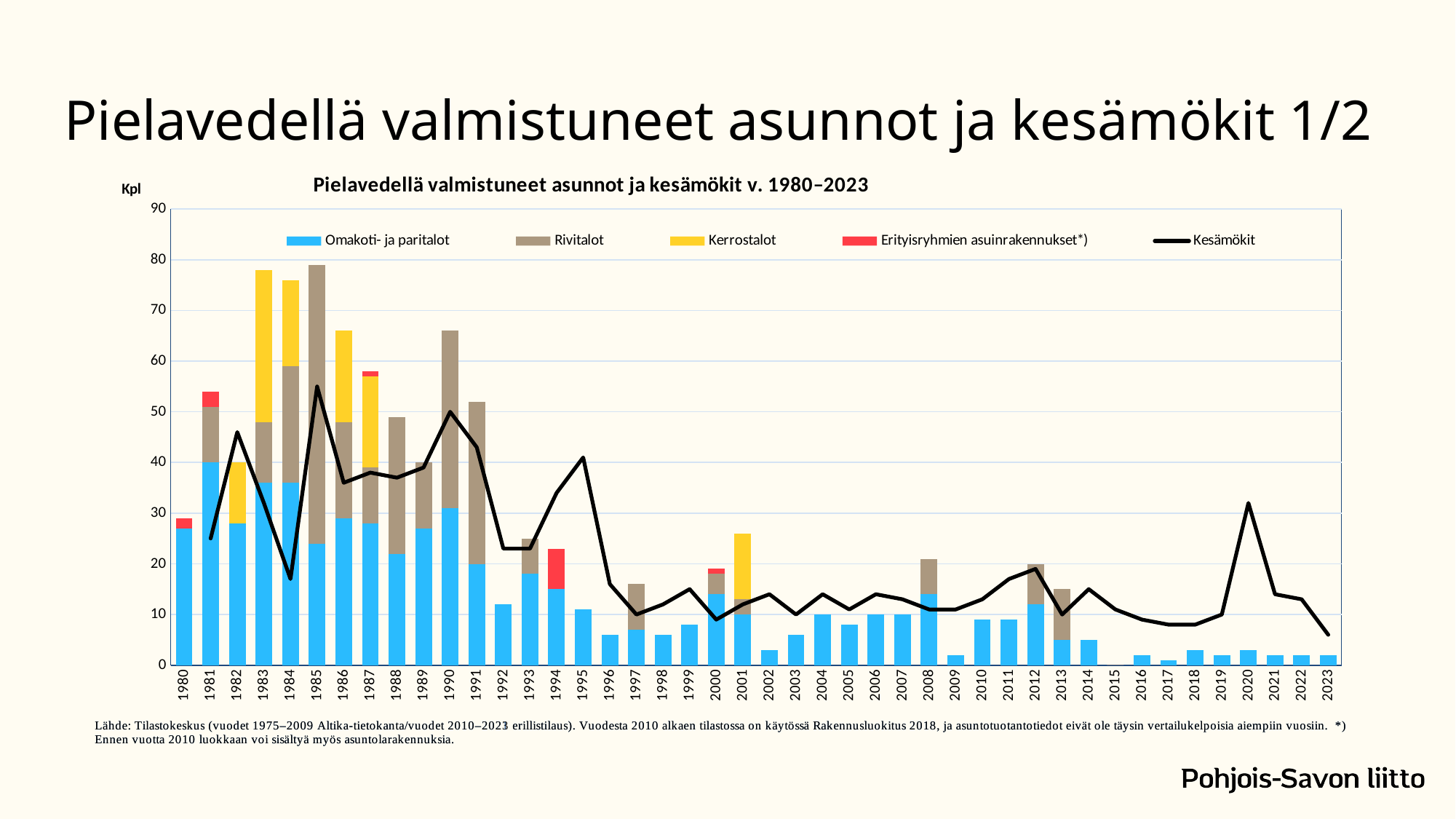
Does the Kesämökit line rise or fall from 2020 to 2023? fall What is the title of the chart? Pielavedellä valmistuneet asunnot ja kesämökit v. 1980–2023 Is the total stacked bar value for 1992 greater or less than 20? less Is the Kesämökit value for 2020 greater or less than 20? greater What kind of chart is this? Stacked bar chart with a line Is the Kesämökit value for 1984 greater or less than 20? less Which series is drawn as a black line rather than as bars? Kesämökit Which year has the higher Kesämökit value, 1985 or 2023? 1985 How many years are shown on the x axis of the chart? 44 How many series does the chart legend list? 5 Which year has the higher total stacked bar, 1983 or 1992? 1983